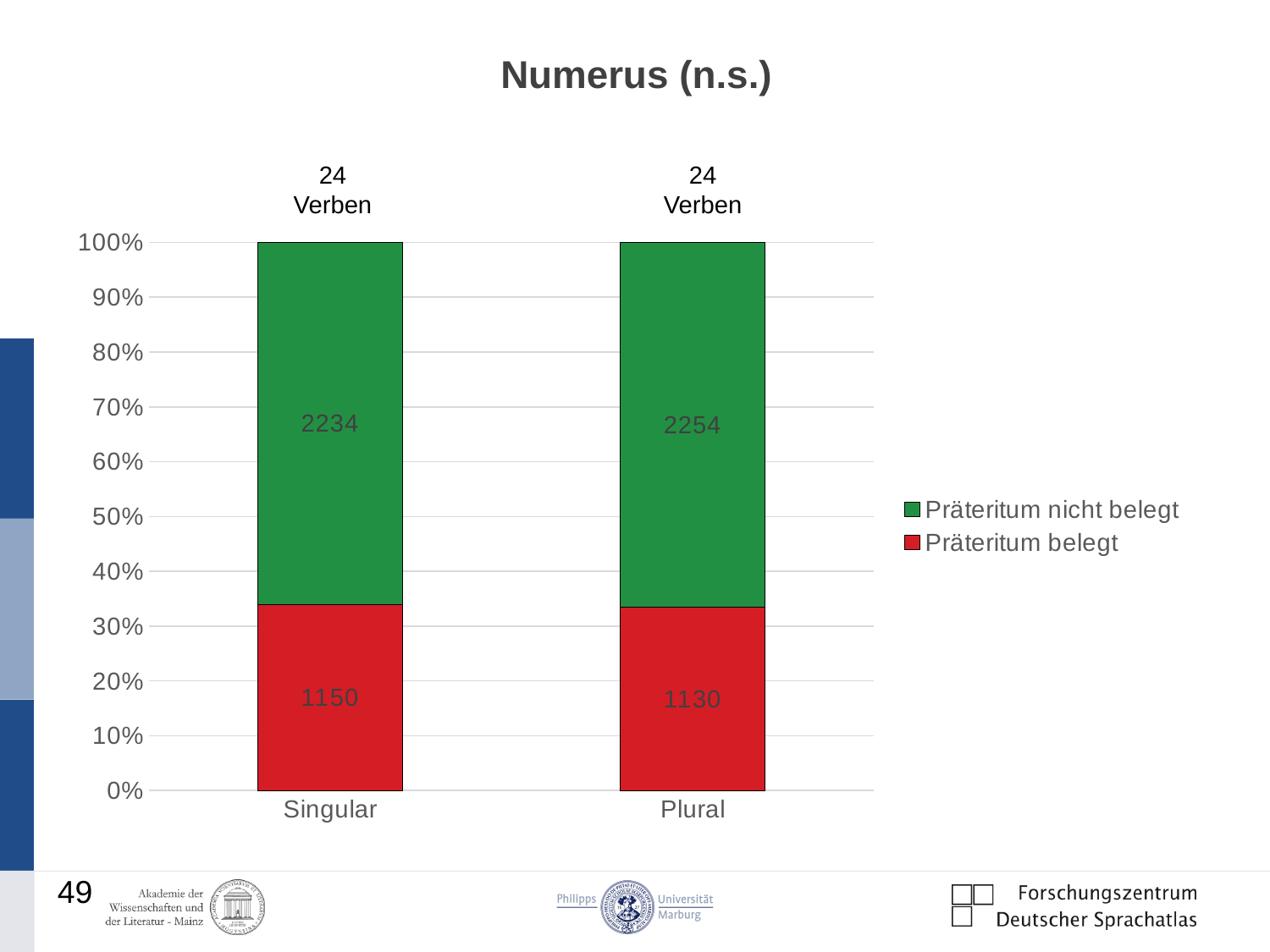
How many categories are shown on the x axis? 2 What is the value of "Präteritum belegt" for Plural? 1130 What is the difference between the "Präteritum nicht belegt" values for Plural and Singular? 20 What is the value of "Präteritum nicht belegt" for Plural? 2254 What type of chart is shown on the slide? stacked bar chart What is the difference between the "Präteritum belegt" values for Singular and Plural? 20 What is the value of "Präteritum nicht belegt" for Singular? 2234 How many series does the legend list? 2 Which category has the higher value for "Präteritum belegt", Singular or Plural? Singular What is the total of the two segments in the Singular bar? 3384 What is the value of "Präteritum belegt" for Singular? 1150 Is the share of "Präteritum belegt" in the Plural bar greater or less than 40%? less